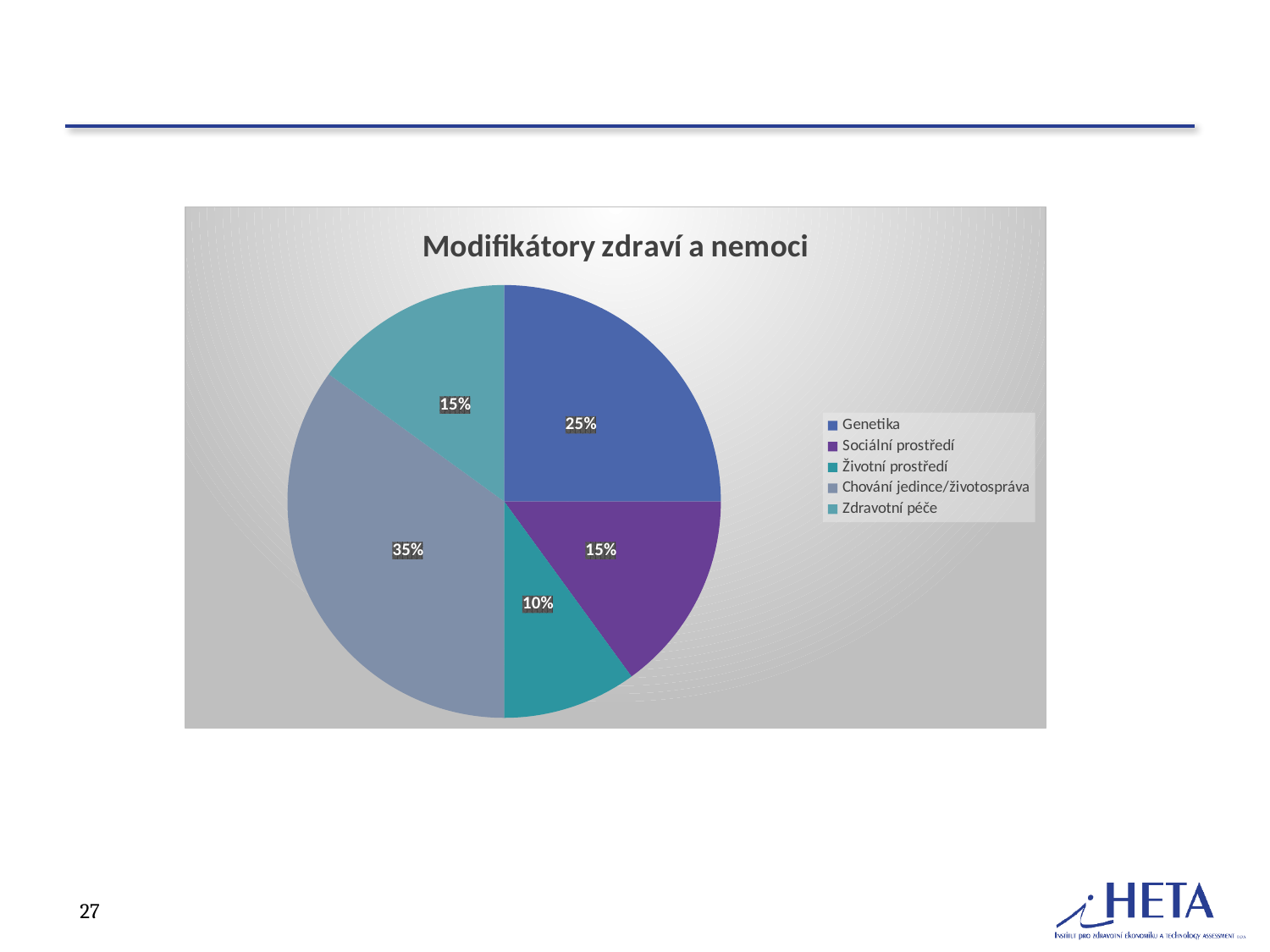
Which category has the smallest slice of the pie? Životní prostředí What share of the pie does Sociální prostředí have? 15% What share of the pie does Chování jedince/životospráva have? 35% Which category has the largest slice of the pie? Chování jedince/životospráva What share of the pie does Životní prostředí have? 10% What kind of chart is shown on the slide? Pie chart What is the title of the chart? Modifikátory zdraví a nemoci What is the difference between the shares of Chování jedince/životospráva and Genetika? 10% How many entries does the legend list? 5 Which is larger, the share for Genetika or the share for Zdravotní péče? Genetika How many categories does the pie chart show? 5